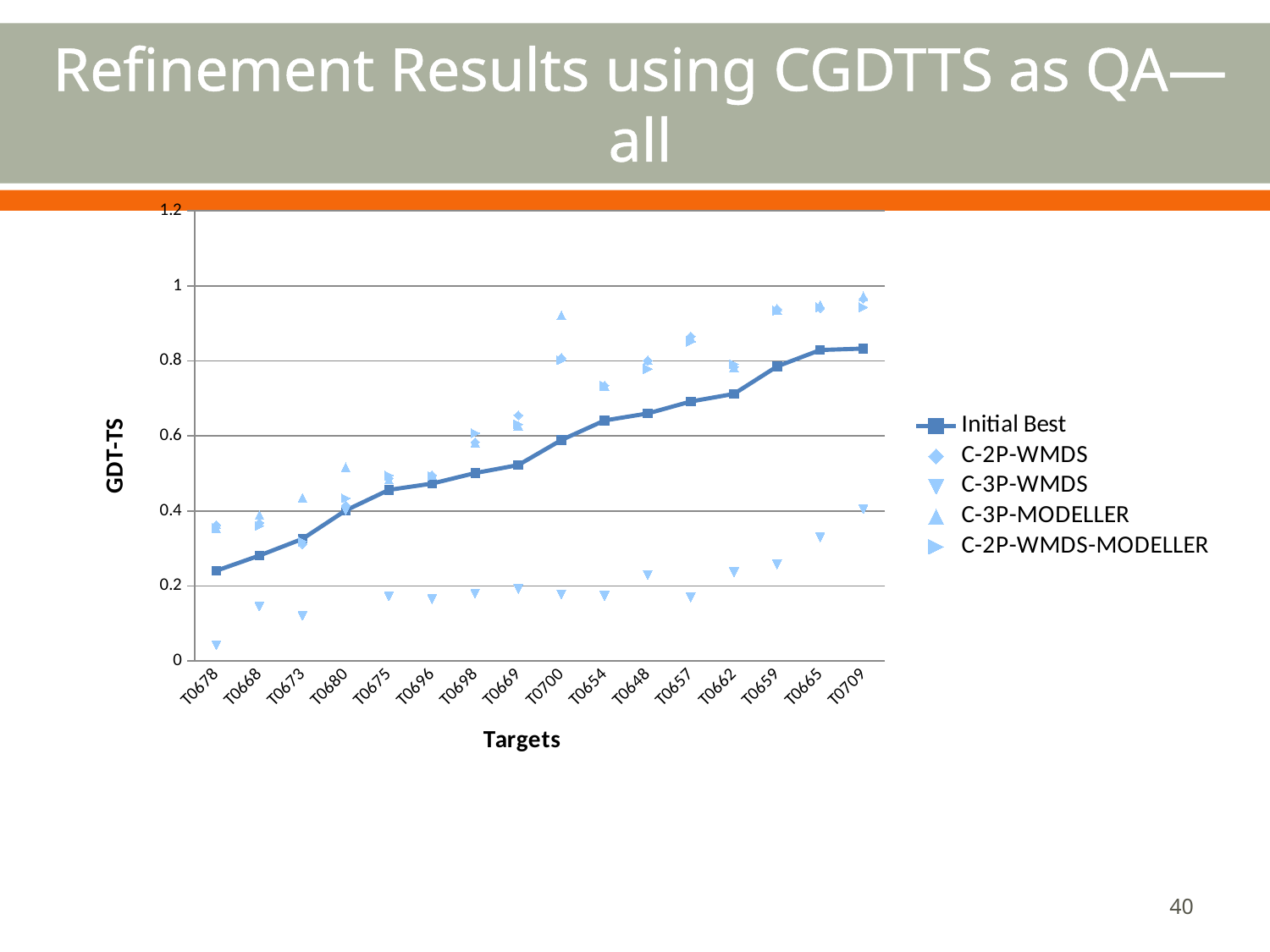
What is the label of the horizontal axis? Targets Is the C-3P-WMDS value for T0678 greater or less than 0.2? less Is the Initial Best value for T0678 greater or less than 0.4? less What is the label of the vertical axis? GDT-TS Is the Initial Best value for T0662 greater or less than 0.6? greater Which is larger, the Initial Best value for T0678 or for T0709? T0709 What kind of chart is shown on the slide? Line chart Does the Initial Best line rise or fall from T0678 to T0709? Rises How many targets are plotted along the x axis? 16 How many series does the legend list? 5